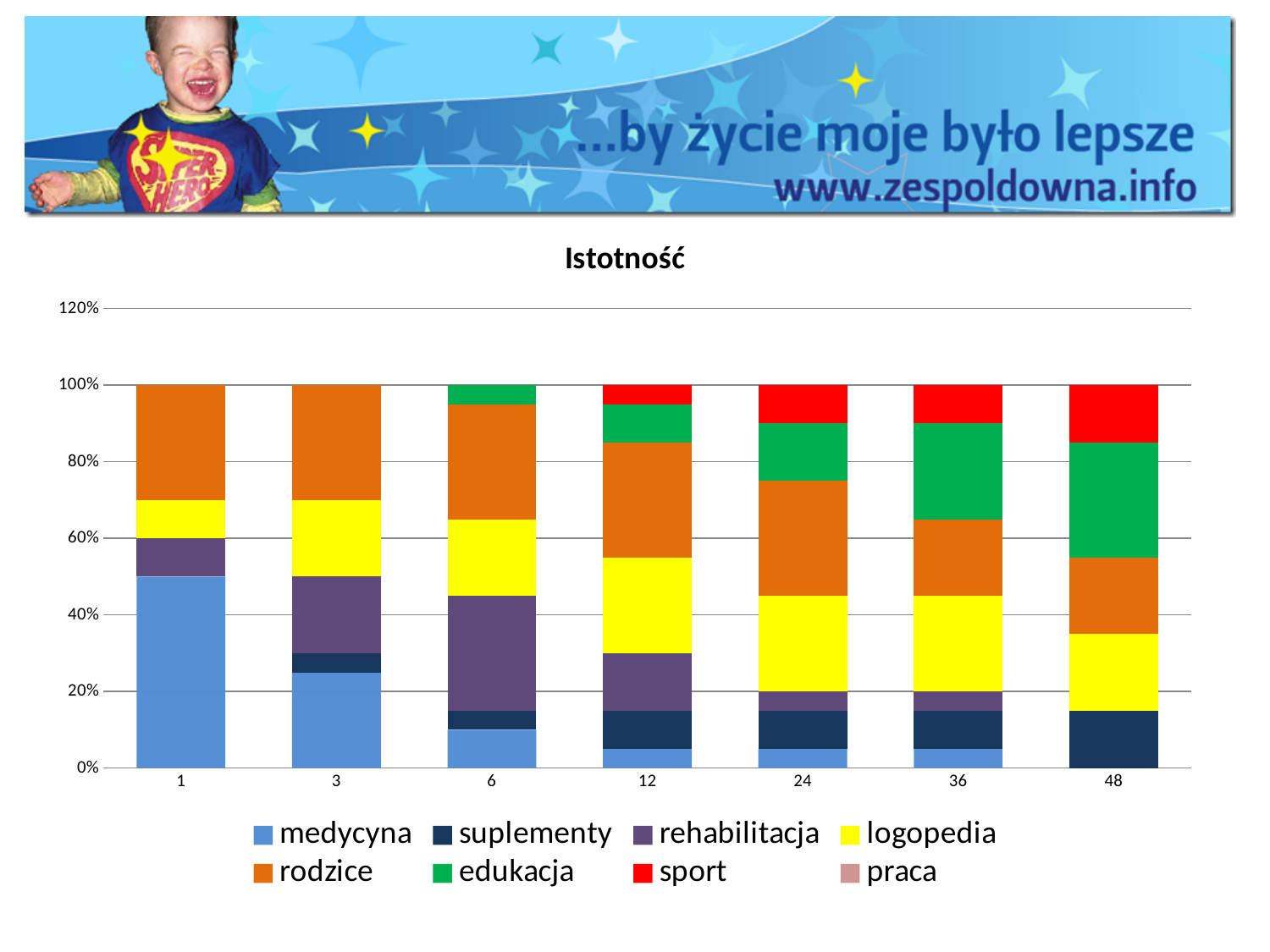
Is the value for 'medycyna' in category 1 greater or less than 40%? greater How many categories are shown on the x axis of the chart? 7 Which category has the largest 'edukacja' segment? 48 What is the title of the chart? Istotność Which category has the largest 'medycyna' segment? 1 Does the share of 'medycyna' rise or fall as you move from category 1 to category 48 along the x axis? fall Which is larger: the 'medycyna' segment in category 1 or in category 3? category 1 What kind of chart is shown on the slide? stacked bar chart Which colour represents the series 'sport' in the chart? red Which category has the largest 'rehabilitacja' segment? 6 How many series does the legend of the chart list? 8 Is the value for 'medycyna' in category 6 greater or less than 20%? less